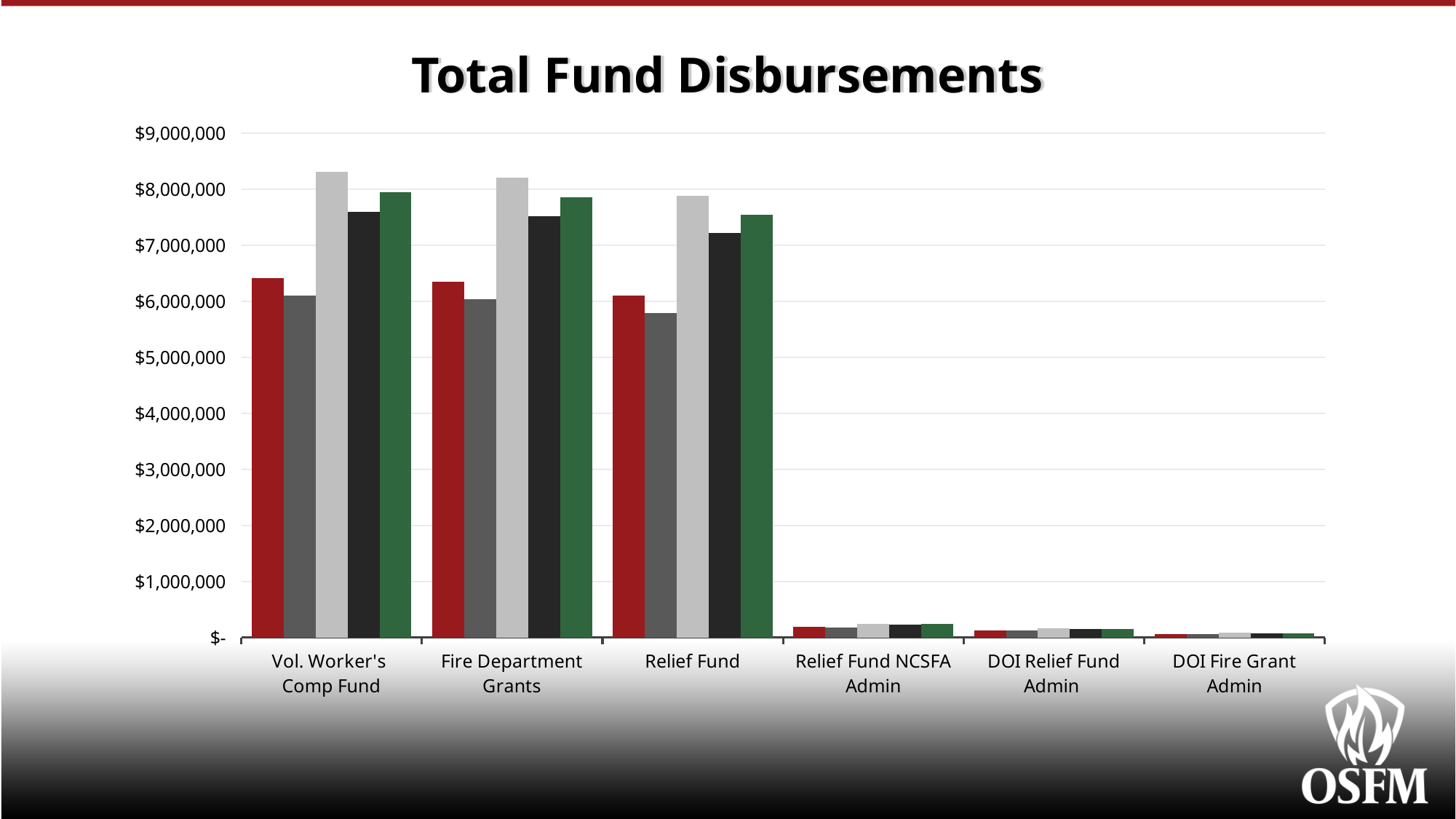
Which category has the lowest disbursements overall in the chart? DOI Fire Grant Admin Which category has larger disbursements: Relief Fund NCSFA Admin or DOI Fire Grant Admin? Relief Fund NCSFA Admin How many bars are plotted for each category in the chart? 5 Within the Vol. Worker's Comp Fund category, which bar is taller: the light grey bar or the dark grey bar? The light grey bar What is the title of the chart? Total Fund Disbursements How many categories are shown on the x axis of the chart? 6 Is the value of the dark grey bar for Relief Fund greater or less than $6,000,000? less Is the value of the light grey bar for Relief Fund greater or less than $8,000,000? less What kind of chart is shown on the slide? Bar chart What is the highest value labelled on the y axis of the chart? $9,000,000 Is the value of the red bar for Vol. Worker's Comp Fund greater or less than $6,000,000? greater